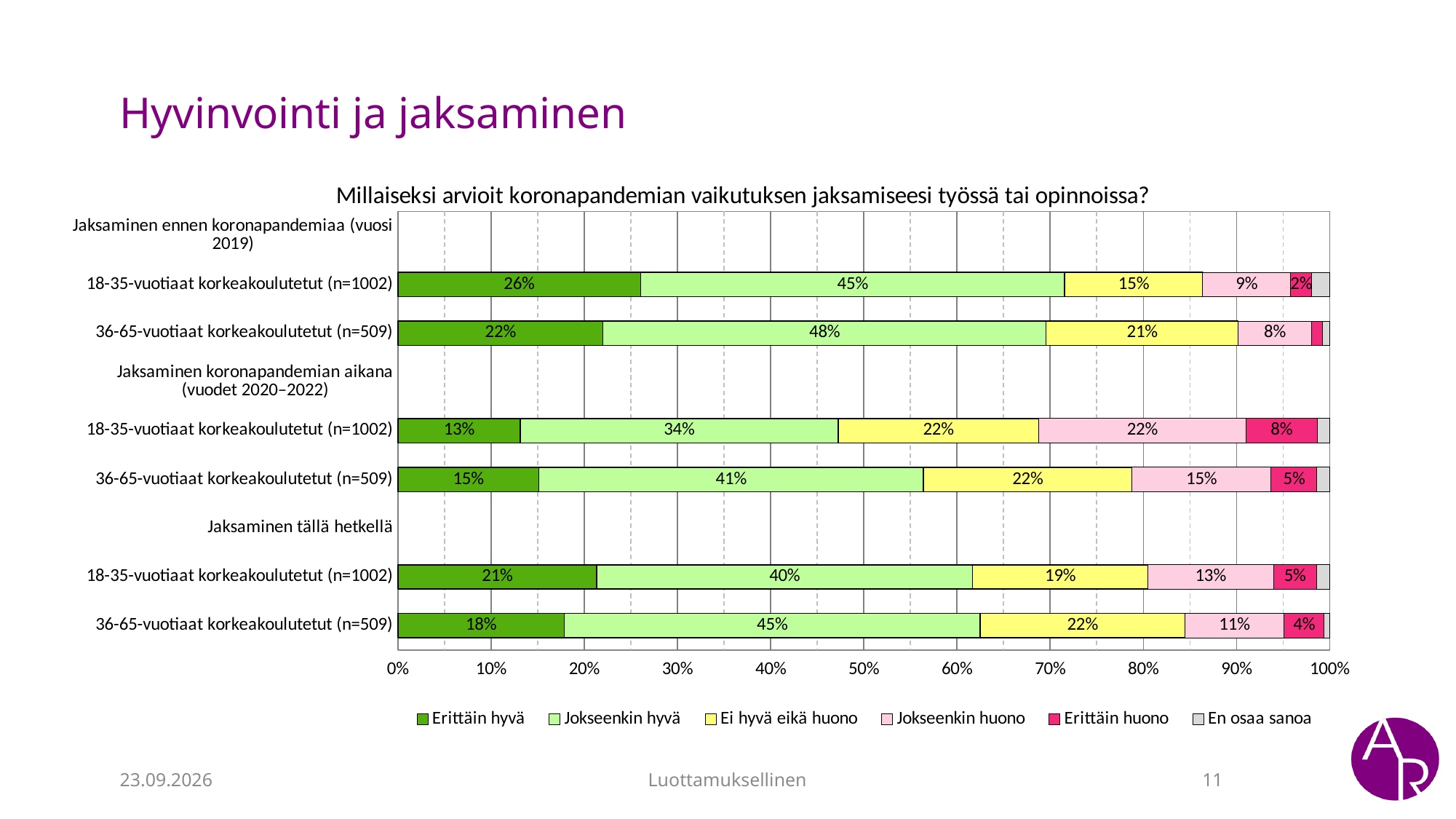
What is the difference in the 'Erittäin hyvä' share for 18-35-vuotiaat korkeakoulutetut between 'Jaksaminen ennen koronapandemiaa' and 'Jaksaminen koronapandemian aikana'? 13 percentage points What is the 'Jokseenkin hyvä' value for 36-65-vuotiaat korkeakoulutetut under 'Jaksaminen koronapandemian aikana (vuodet 2020–2022)'? 41% What is the 'Erittäin huono' value for 36-65-vuotiaat korkeakoulutetut under 'Jaksaminen tällä hetkellä'? 4% Under 'Jaksaminen koronapandemian aikana', which group has the larger 'Erittäin huono' share: 18-35-vuotiaat or 36-65-vuotiaat korkeakoulutetut? 18-35-vuotiaat korkeakoulutetut Which bar has the highest 'Erittäin hyvä' share? 18-35-vuotiaat korkeakoulutetut, Jaksaminen ennen koronapandemiaa (vuosi 2019) What is the 'Jokseenkin huono' value for 18-35-vuotiaat korkeakoulutetut under 'Jaksaminen tällä hetkellä'? 13% What is the 'Erittäin hyvä' value for 18-35-vuotiaat korkeakoulutetut under 'Jaksaminen ennen koronapandemiaa (vuosi 2019)'? 26% How many bars (respondent groups with data) are plotted in the chart? 6 Which bar has the lowest 'Erittäin hyvä' share? 18-35-vuotiaat korkeakoulutetut, Jaksaminen koronapandemian aikana (vuodet 2020–2022) How many series does the legend list? 6 What kind of chart is shown on the slide? Stacked bar chart Which legend entry is shown in yellow? Ei hyvä eikä huono